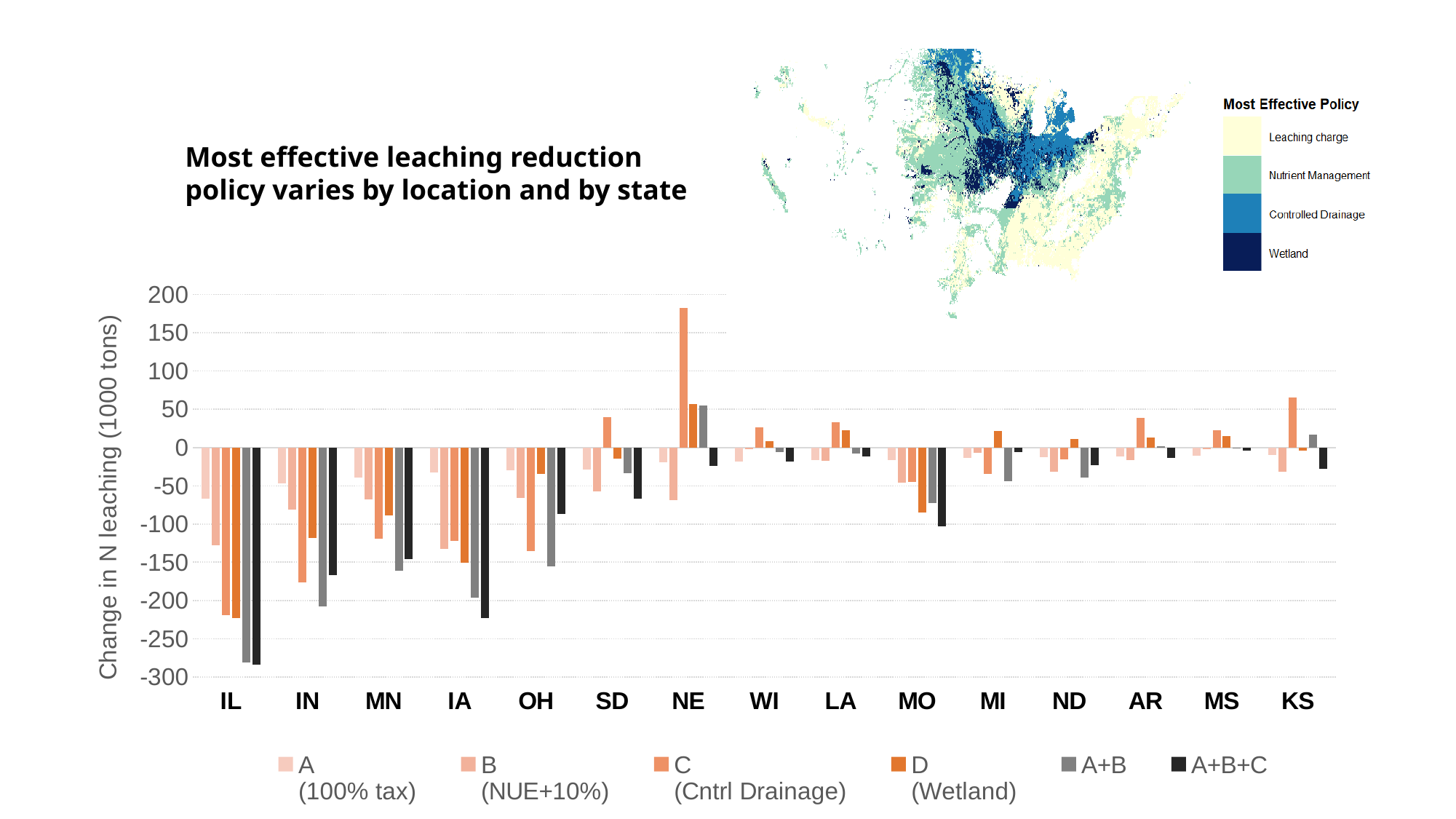
Is the value for series C in OH greater or less than -100? less Is the value for series A+B+C in MO greater or less than -50? less What kind of chart is used to show the change in N leaching by state? bar chart How many series does the legend of the bar chart list? 6 Is the value for series C in NE greater or less than 150? greater How many states are shown on the x axis of the bar chart? 15 Which state has the lowest value for series A+B+C? IL Which state has the highest value for series C (Cntrl Drainage)? NE What is the label of the y axis of the bar chart? Change in N leaching (1000 tons) In IN, which is larger: the value for series C or the value for series D? D Which is larger: the value for series C in KS or the value for series C in SD? KS